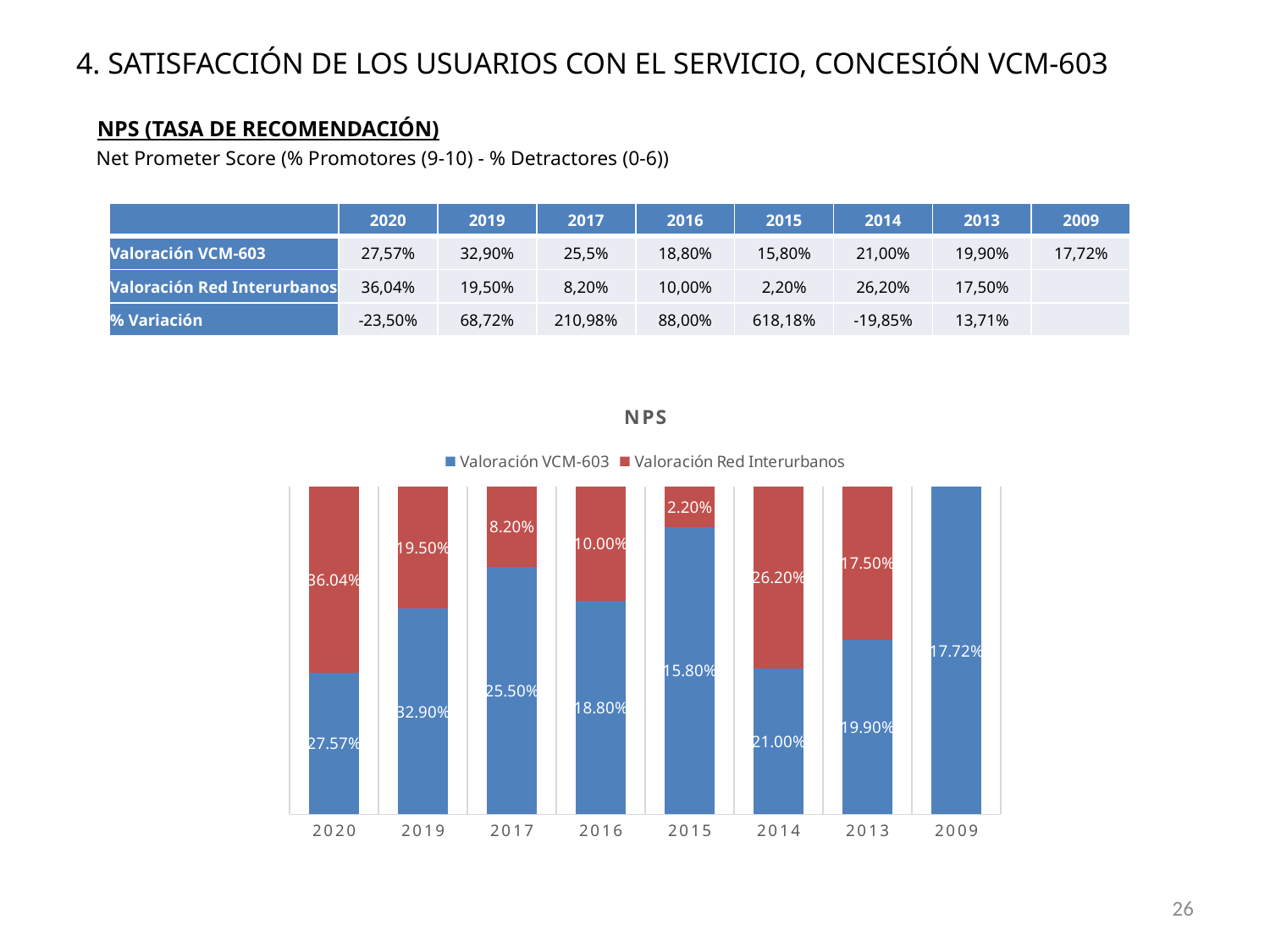
How many year categories are shown on the x axis of the NPS chart? 8 In the NPS chart, which year has the lowest value for Valoración VCM-603? 2015 In the NPS chart, which series is shown in red? Valoración Red Interurbanos In the NPS chart for 2017, which is larger: Valoración VCM-603 or Valoración Red Interurbanos? Valoración VCM-603 How many series does the legend of the NPS chart list? 2 In the NPS chart, which year has the lowest value for Valoración Red Interurbanos? 2015 In the NPS chart, what is the difference between Valoración Red Interurbanos and Valoración VCM-603 in 2020? 8.47% In the NPS chart, which year has the highest value for Valoración VCM-603? 2019 In the NPS chart, what is the value of Valoración VCM-603 for 2009? 17.72% What type of chart is shown under the title NPS? Stacked bar chart In the NPS chart, what is the value of Valoración VCM-603 for 2020? 27.57% In the NPS chart, what is the value of Valoración Red Interurbanos for 2014? 26.20%